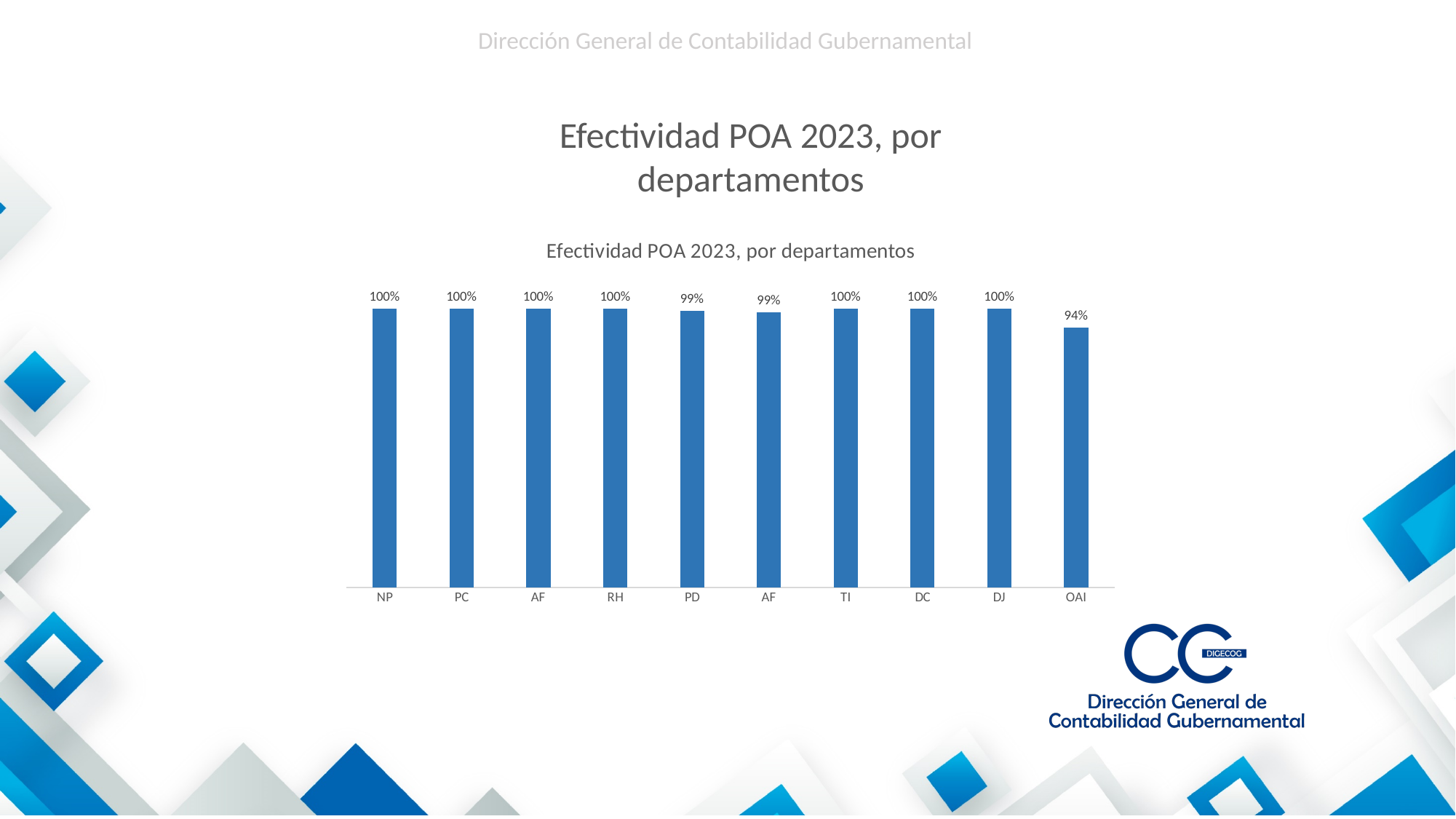
What is the difference between the values for NP and OAI? 6% Which department has the lowest value? OAI How many departments are shown on the x axis? 10 What kind of chart is shown on the slide? Bar chart What is the title of the chart? Efectividad POA 2023, por departamentos What is the difference between the values for PD and OAI? 5% Which is larger, the value for TI or the value for OAI? TI What is the value for NP? 100% What is the value for OAI? 94% What is the value for PD? 99% How many bars have a value of 100%? 7 What is the value for DJ? 100%